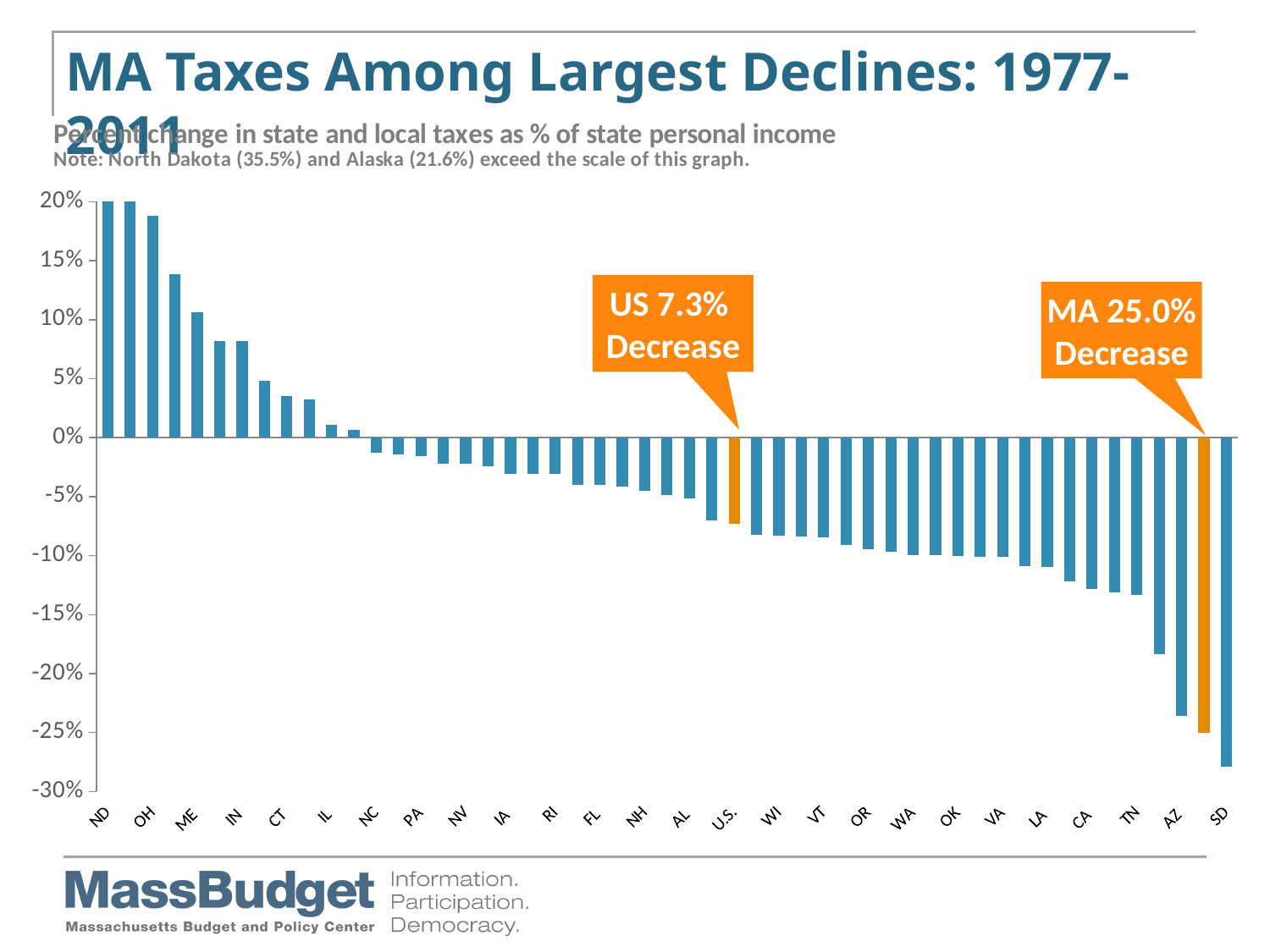
Is the value for OH greater or less than 15%? greater Which has the larger value, OH or ME? OH Which state has the largest increase in the chart? ND What kind of chart is shown on the slide? bar chart How many percentage points larger is the MA decrease than the U.S. decrease? 17.7 percentage points Is the value for SD greater or less than -25%? less Which state has the largest decline in the chart? SD According to the note, what is the value for North Dakota? 35.5% Do the values rise or fall moving from left to right along the x axis? fall According to the note, what is the value for Alaska? 21.6% According to the callout, what is the percent change for MA? 25.0% decrease According to the callout, what is the percent change for the U.S.? 7.3% decrease